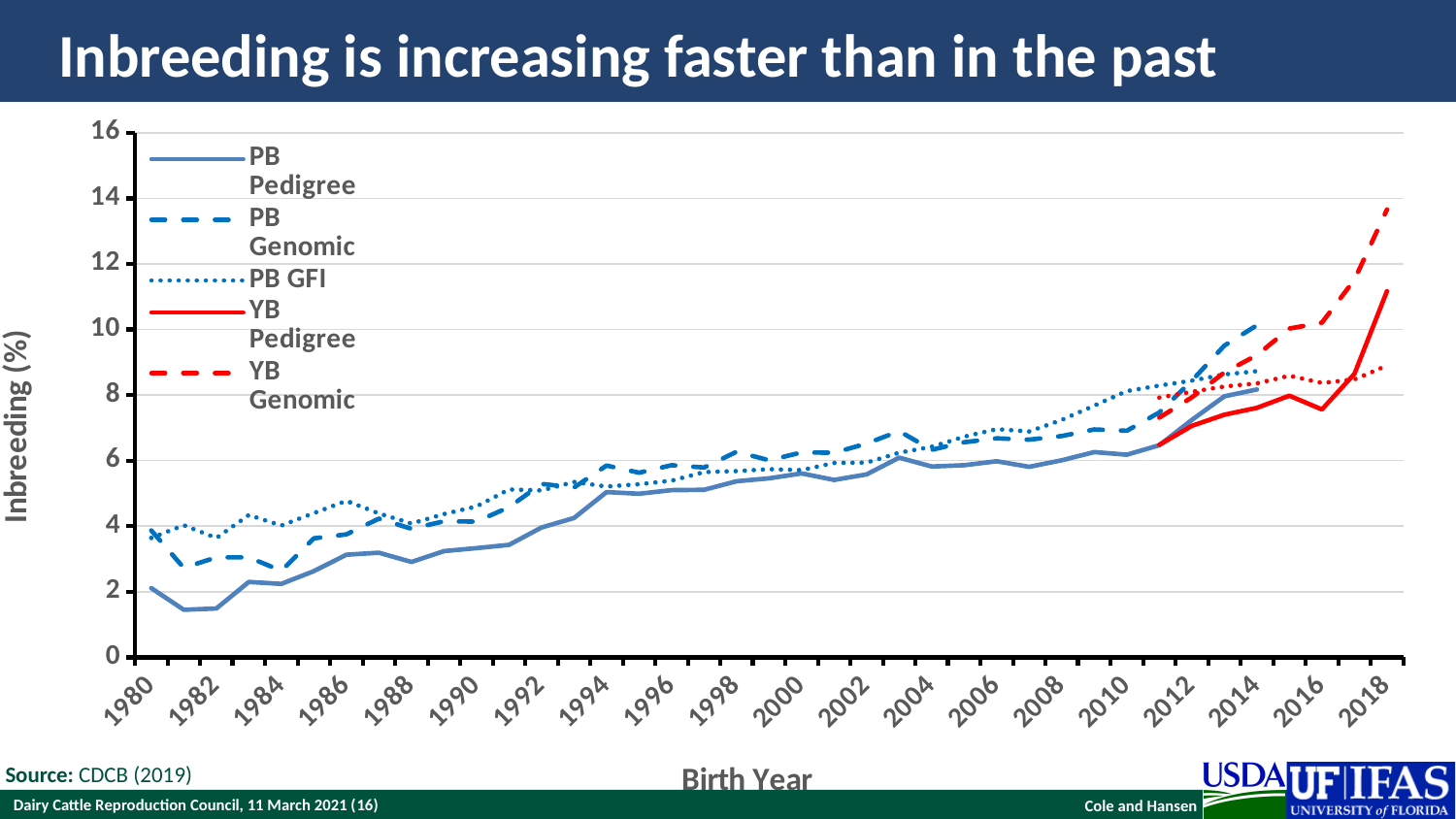
What is the label of the y axis? Inbreeding (%) In 1980, which is larger: PB GFI or PB Pedigree? PB GFI What kind of chart is shown on the slide? line chart Is the value for PB Pedigree in 1990 greater or less than 4? less How many series does the legend list? 5 Is the value for PB Pedigree in 2000 greater or less than 6? less What is the title of the chart? Inbreeding is increasing faster than in the past Which series reaches the highest value in 2018? YB Genomic Is the value for YB Genomic in 2018 greater or less than 12? greater Does the PB Pedigree series generally rise or fall from 1980 to 2018? rise